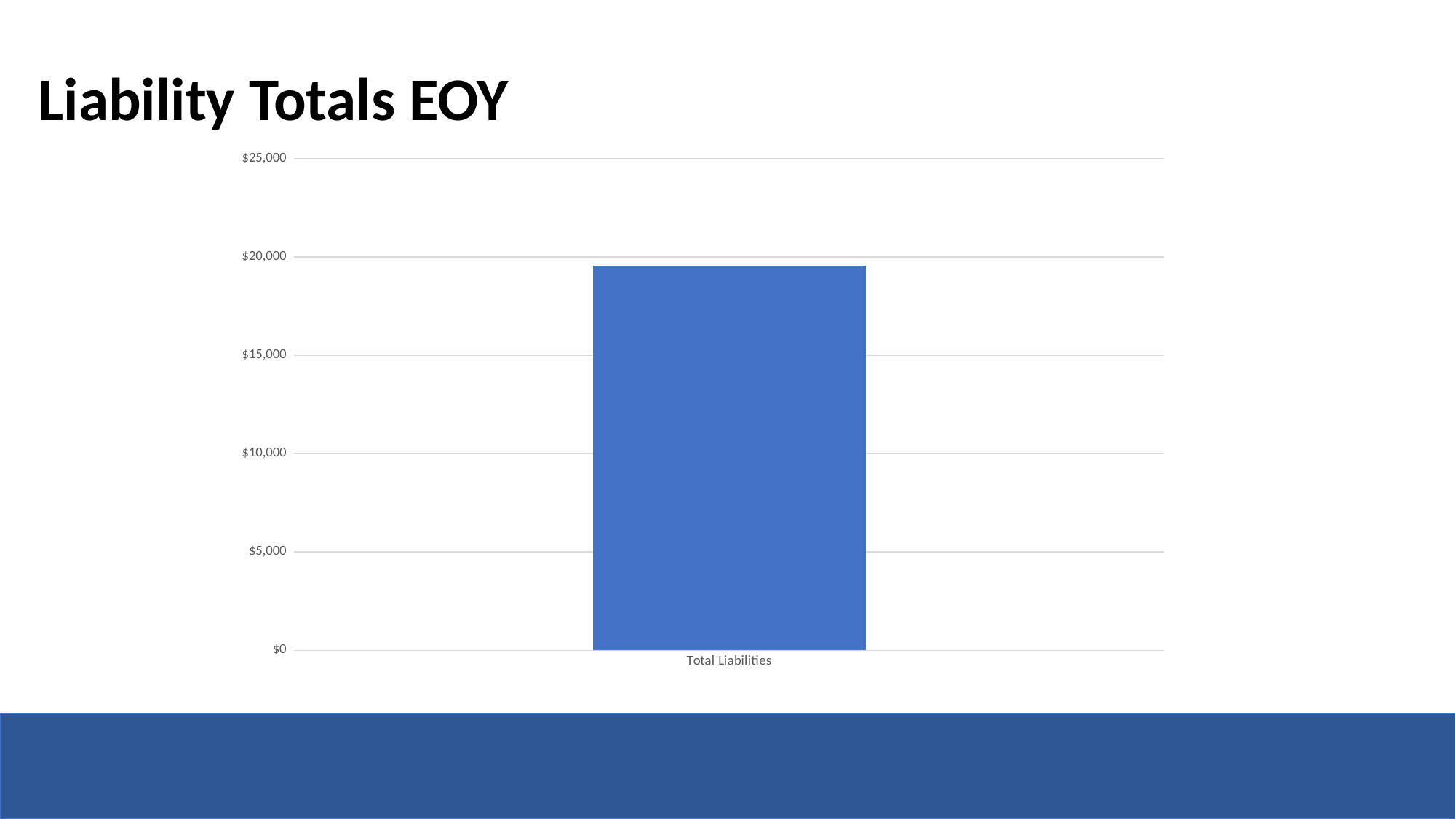
What is the highest value shown on the y axis? $25,000 Is the value for Total Liabilities greater or less than $20,000? less Is the value for Total Liabilities greater or less than $10,000? greater How many bars does the chart show? 1 What is the label of the single category on the x axis? Total Liabilities Is the value for Total Liabilities greater or less than $15,000? greater What kind of chart is shown on the slide? bar chart